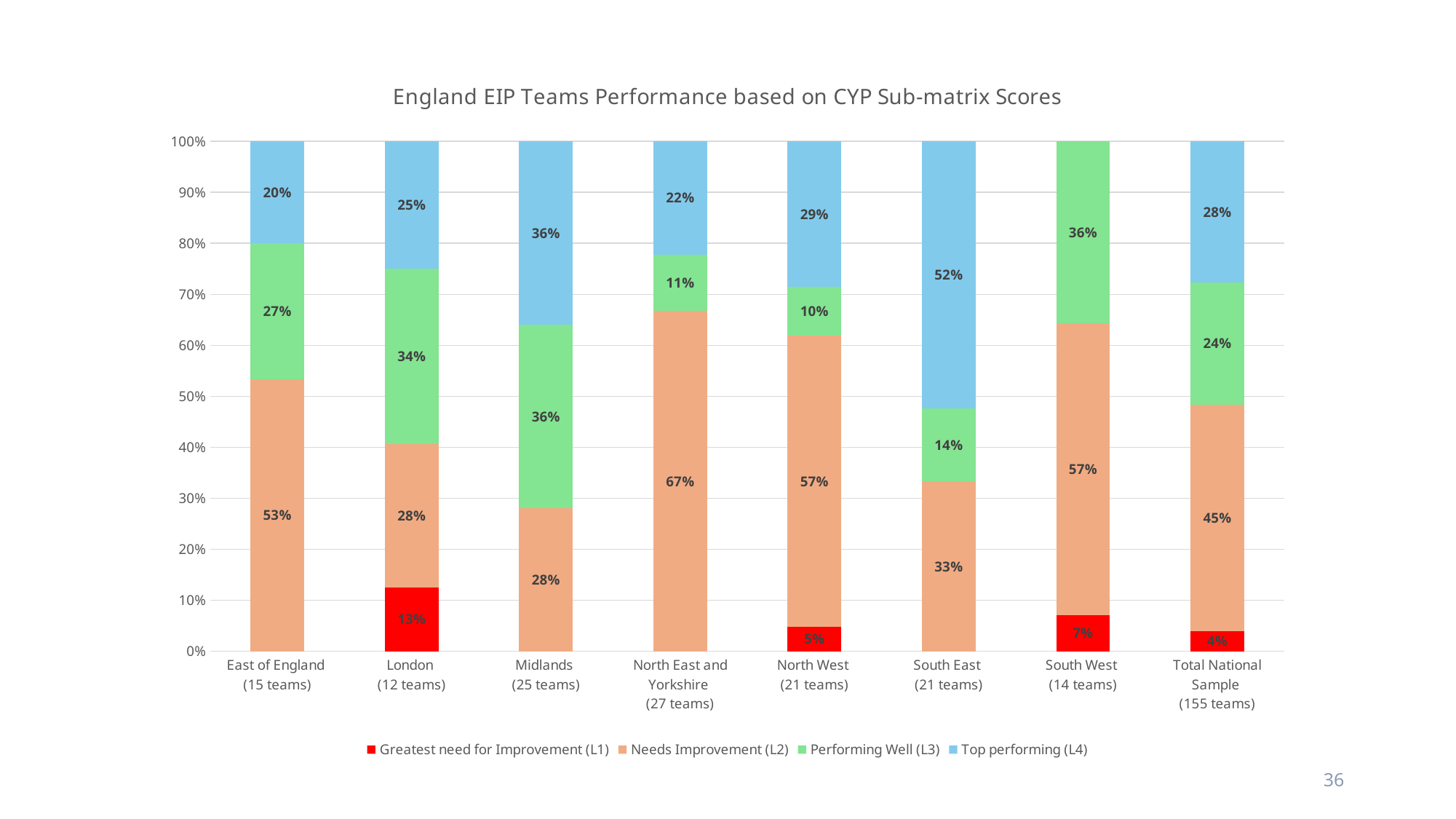
What is the Needs Improvement (L2) percentage for North East and Yorkshire? 67% Which region has the highest Needs Improvement (L2) percentage? North East and Yorkshire What is the Greatest need for Improvement (L1) percentage for the Total National Sample? 4% What percentage of South East teams are in the Top performing (L4) category? 52% What is the Performing Well (L3) percentage for the Midlands? 36% How many series does the legend list? 4 Which region has the highest Top performing (L4) percentage? South East How many regional/sample categories are shown on the x axis? 8 Which has a larger Greatest need for Improvement (L1) percentage, London or South West? London How many percentage points higher is the Needs Improvement (L2) share for East of England than for London? 25 percentage points What type of chart is shown on the slide? Stacked bar chart Which region has the lowest Performing Well (L3) percentage? North West